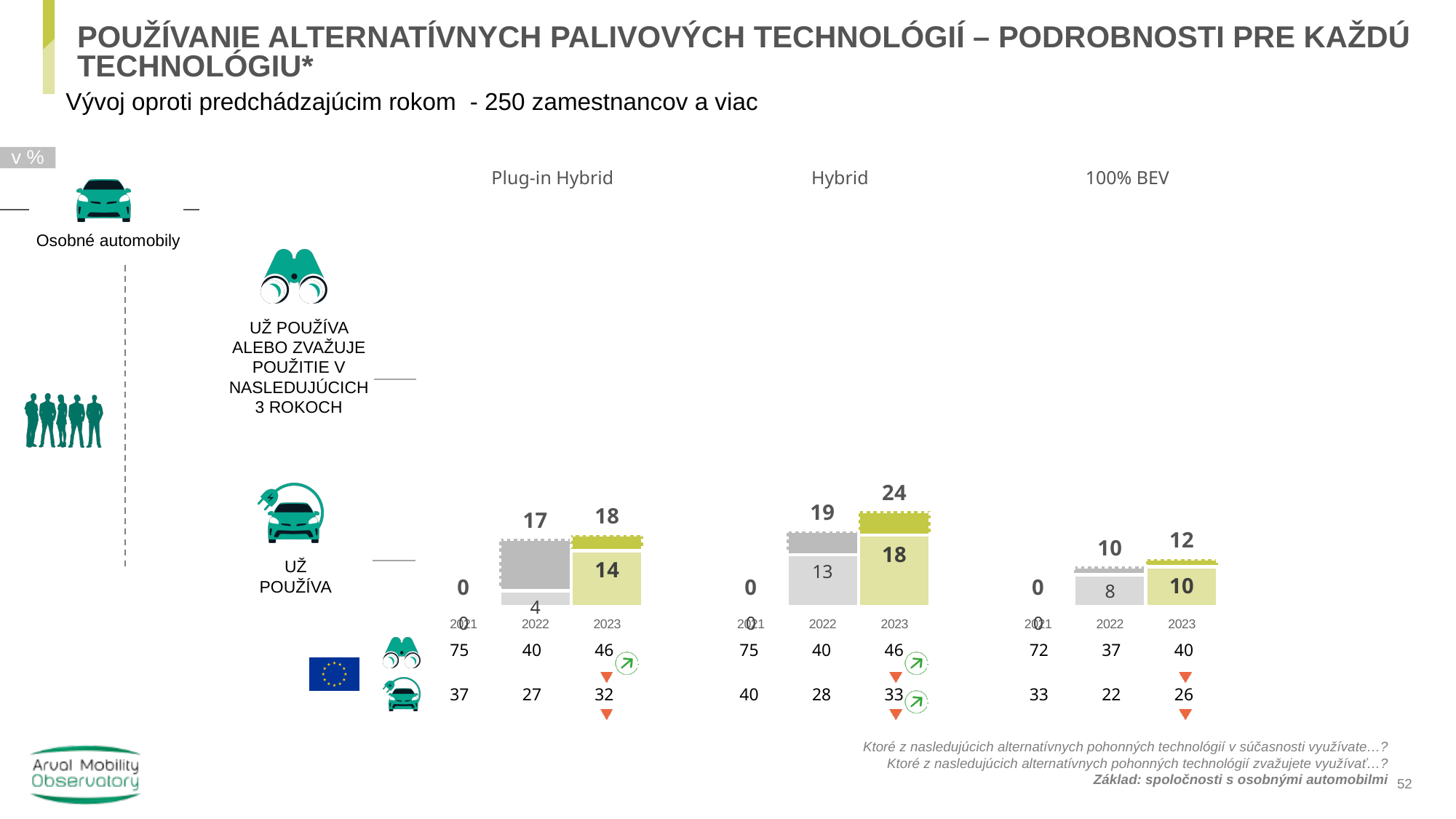
Which three technologies are the charts on the slide about? Plug-in Hybrid, Hybrid, 100% BEV In the Plug-in Hybrid chart, what is the 'UŽ POUŽÍVA' value for 2022? 4 In the Hybrid chart, which year has the highest top value? 2023 In the Hybrid chart, do the top values rise or fall from 2021 to 2023? Rise In the Hybrid chart, what is the top value (už používa alebo zvažuje) for 2023? 24 In the Hybrid chart, what is the difference between the top values for 2023 and 2022? 5 How many years are shown on the x axis of the Hybrid chart? 3 Which is larger: the 2023 top value in the Plug-in Hybrid chart or the 2023 top value in the 100% BEV chart? Plug-in Hybrid In the Plug-in Hybrid chart, what is the 'UŽ POUŽÍVA' value for 2023? 14 What kind of chart is used for the Plug-in Hybrid data? Bar chart In the 100% BEV chart, what is the 'UŽ POUŽÍVA' value for 2022? 8 In the 100% BEV chart, what is the 'UŽ POUŽÍVA' value for 2023? 10